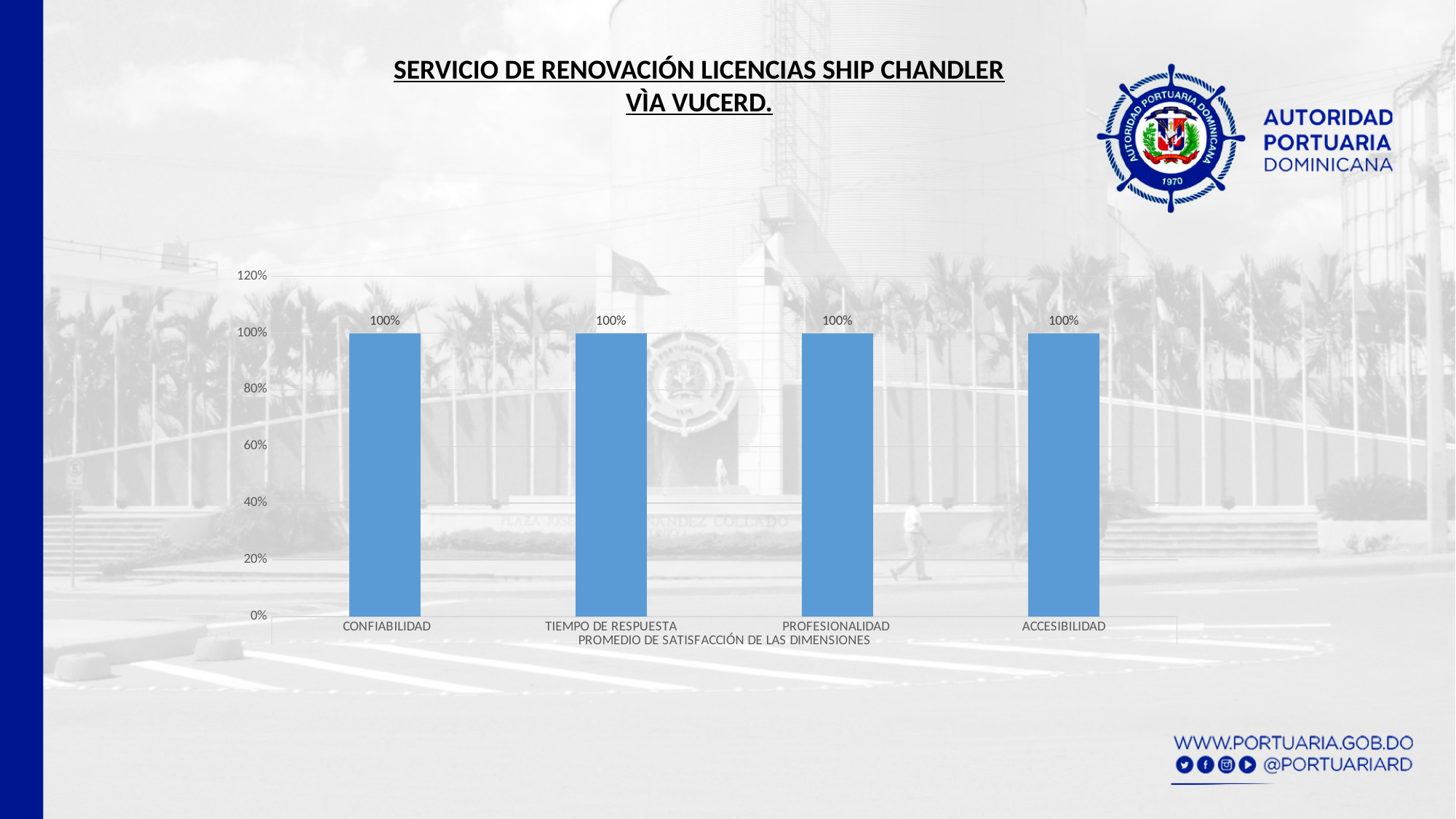
What kind of chart is shown on the slide? bar chart What is the difference between the values for CONFIABILIDAD and ACCESIBILIDAD? 0% Is the value for PROFESIONALIDAD greater or less than 80%? greater What is the value for PROFESIONALIDAD? 100% What is the label printed below the category names on the x axis? PROMEDIO DE SATISFACCIÓN DE LAS DIMENSIONES How many categories are shown on the x axis of the chart? 4 Do the values rise, fall or stay flat across the categories from CONFIABILIDAD to ACCESIBILIDAD? stay flat What is the value for TIEMPO DE RESPUESTA? 100% What is the value for CONFIABILIDAD? 100% What is the value for ACCESIBILIDAD? 100% What is the highest value shown on the vertical axis of the chart? 120%